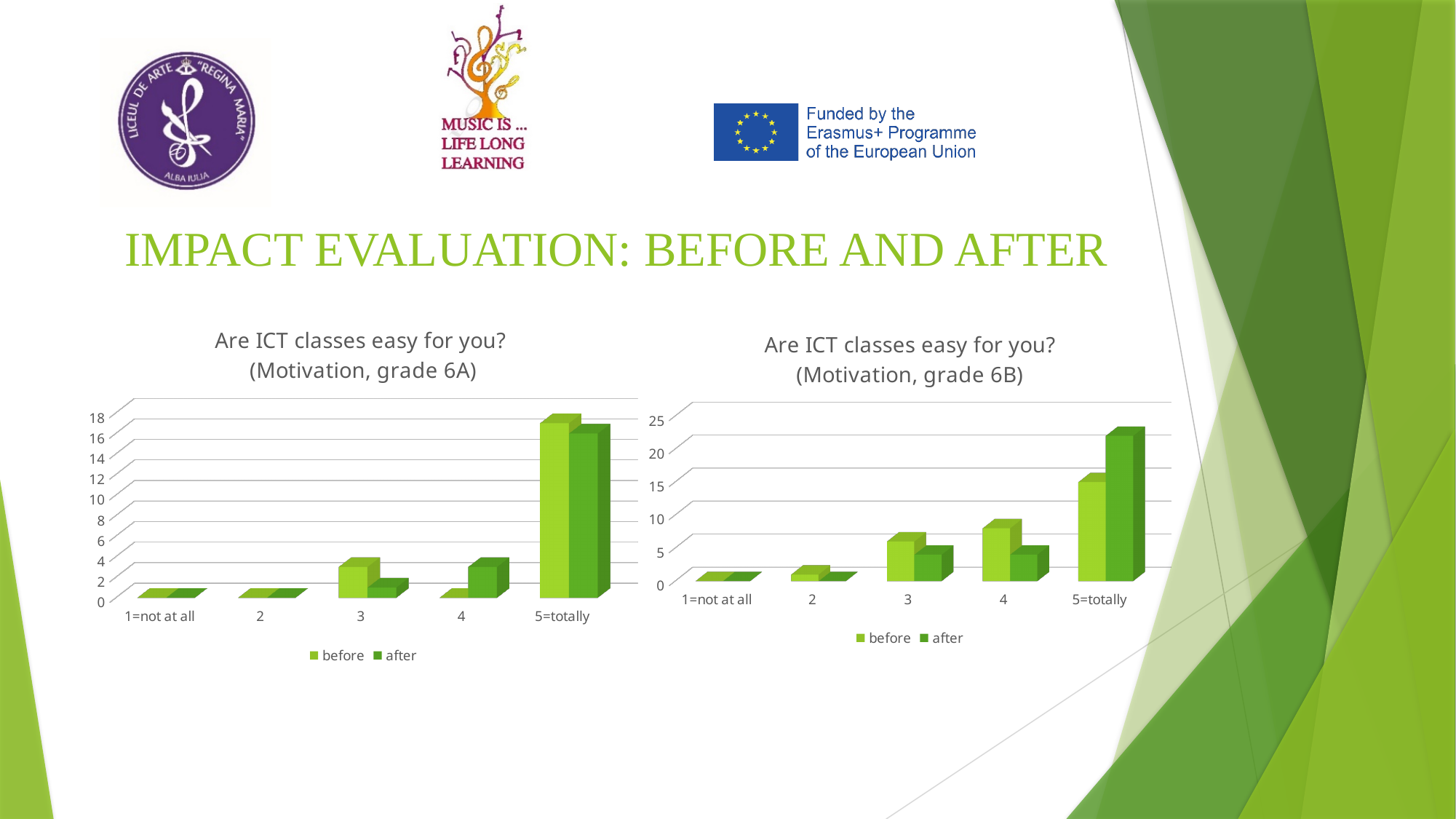
What are the two legend entries in the grade 6A chart? before, after How many series does the legend of the grade 6B chart list? 2 In the grade 6A chart, which category has the highest 'before' value? 5=totally In the grade 6A chart, which is larger for category 3, 'before' or 'after'? before In the grade 6B chart, which is larger for 5=totally, 'before' or 'after'? after How many categories are shown on the x axis of the grade 6A chart? 5 In the grade 6A chart, is the 'before' value for 5=totally greater or less than 10? greater In the grade 6B chart, is the 'after' value for 5=totally greater or less than 20? greater In the grade 6B chart, which is larger for category 4, 'before' or 'after'? before In the grade 6B chart, which category has the highest 'after' value? 5=totally What kind of chart is the 'Are ICT classes easy for you? (Motivation, grade 6A)' chart? bar chart In the grade 6B chart, is the 'before' value for 5=totally greater or less than 20? less